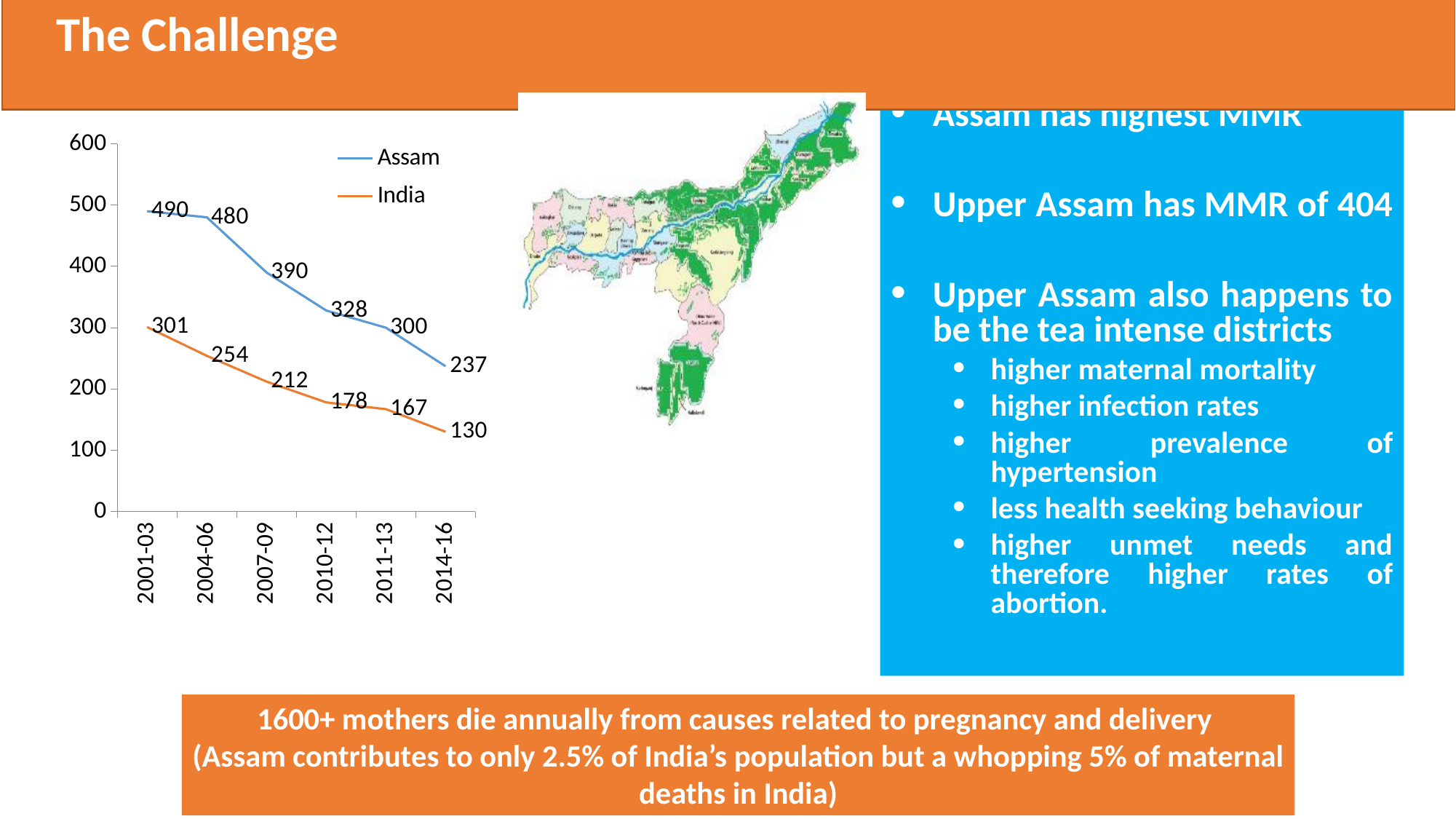
What kind of chart is shown on the slide? line chart What is the value for Assam in 2001-03? 490 What is the difference between the Assam and India values in 2014-16? 107 What is the value for India in 2007-09? 212 In which period is the India series at its highest? 2001-03 How many periods are shown on the x axis? 6 What is the value for Assam in 2010-12? 328 What is the value for India in 2014-16? 130 In which period is the Assam series at its lowest? 2014-16 How many series does the legend list? 2 Is the value for India in 2004-06 greater or less than 300? less Which series has the larger value in 2011-13, Assam or India? Assam